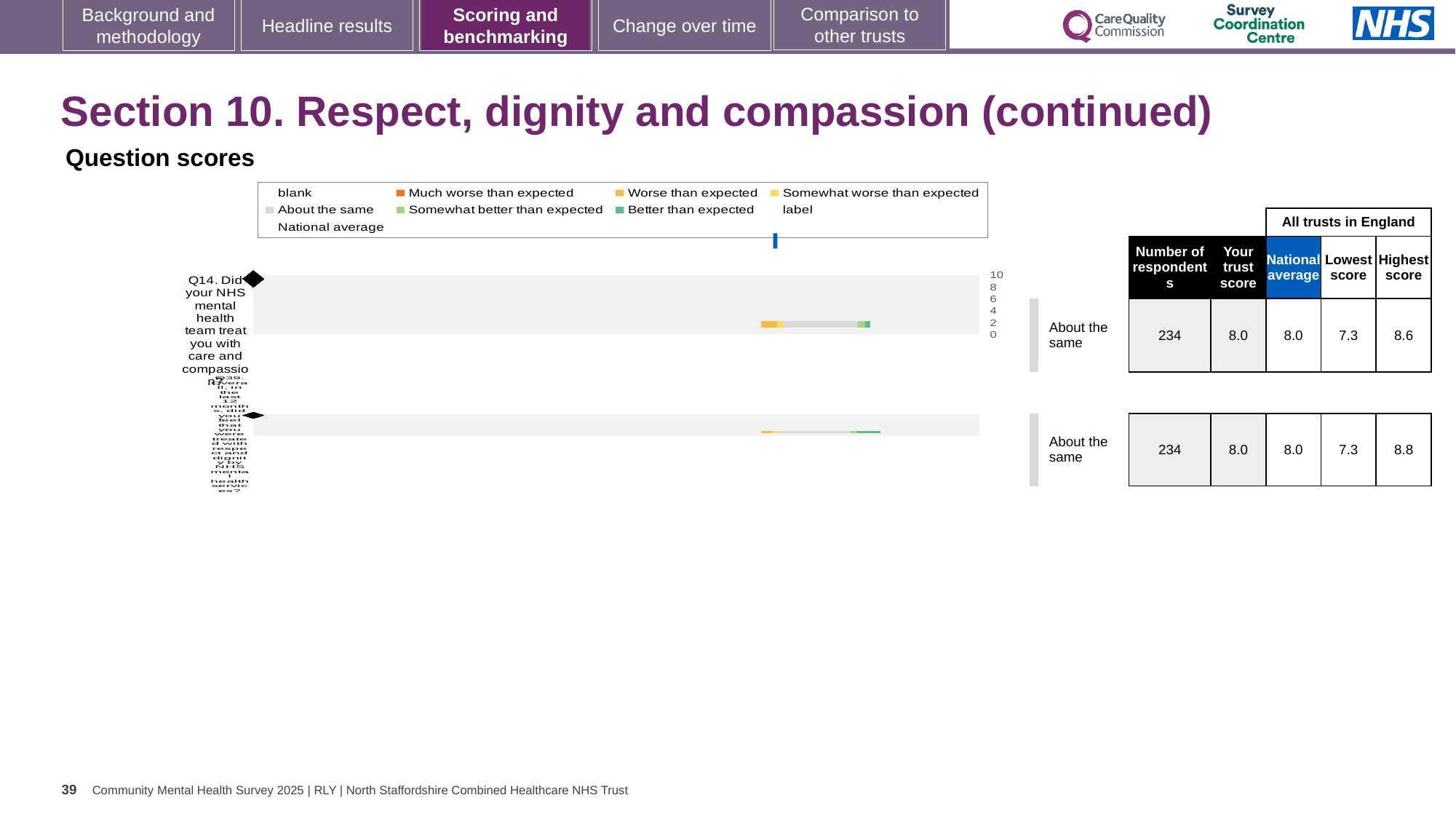
What is the national average for Q39 shown next to the chart? 8.0 What is the lowest score across all trusts in England for Q14? 7.3 Which question has the higher 'Highest score' across all trusts in England, Q14 or Q39? Q39 What benchmark category is shown for Q14 in the chart? About the same What kind of chart is used to show the question scores on this slide? bar chart How many questions are plotted in the question scores chart? 2 What colour does the legend use for 'Better than expected'? green What is the difference between the highest score and the lowest score for Q14? 1.3 What is the trust score for Q14 shown next to the chart? 8.0 What is the highest value shown on the chart's score axis? 10 What is the highest score across all trusts in England for Q39? 8.8 How many respondents answered Q14? 234